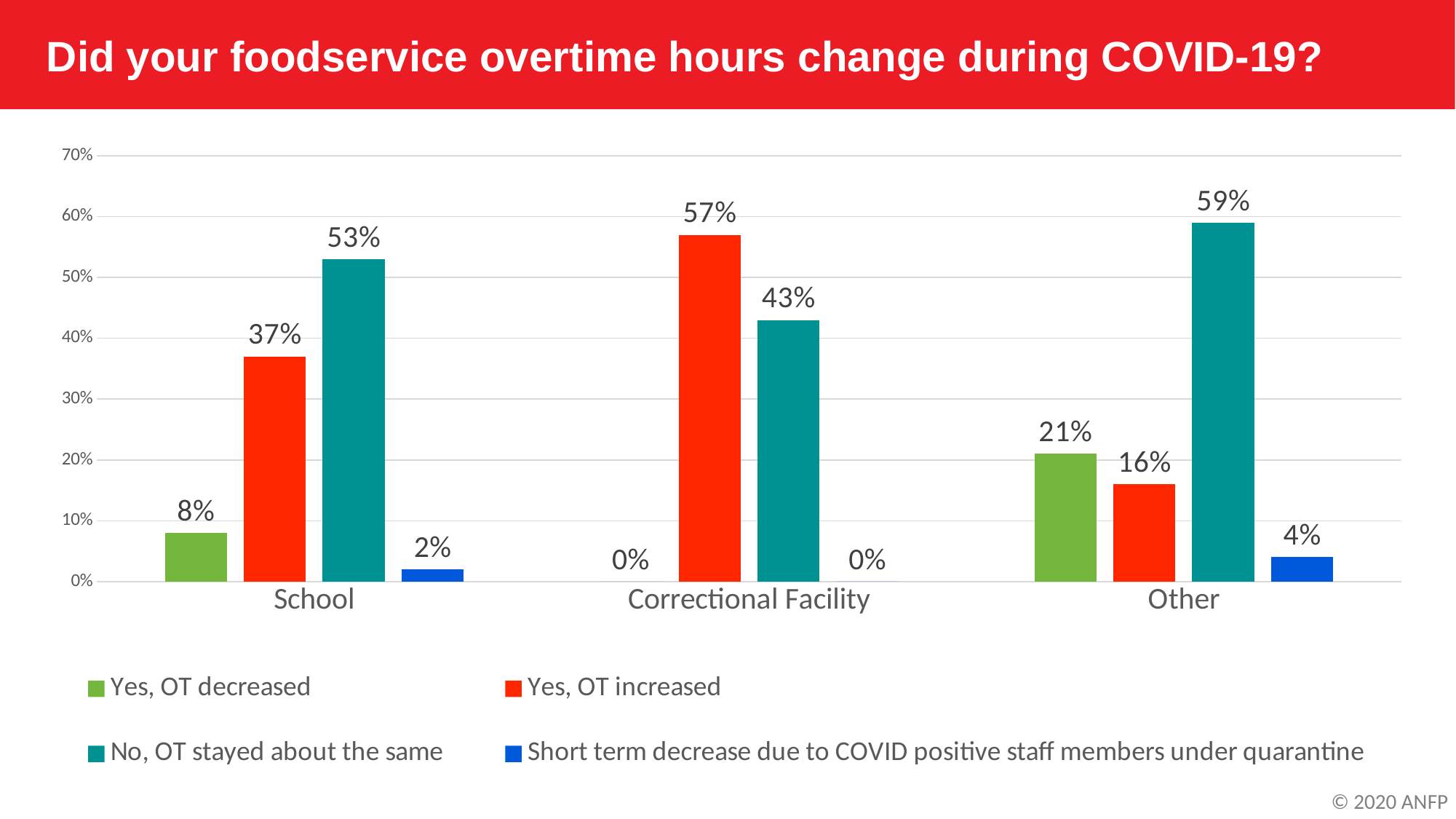
How many series does the legend list? 4 Which category has the highest value for 'No, OT stayed about the same'? Other What percentage of School respondents said OT stayed about the same? 53% What is the title of the chart? Did your foodservice overtime hours change during COVID-19? What is the value for 'Yes, OT decreased' in the Correctional Facility category? 0% Which is larger for the Other category: 'Yes, OT decreased' or 'Yes, OT increased'? Yes, OT decreased Which category has the lowest value for 'Yes, OT increased'? Other What kind of chart is shown on the slide? Bar chart What percentage of Other respondents reported a short term decrease due to COVID positive staff members under quarantine? 4% How many categories are shown on the x axis? 3 What is the value for 'Yes, OT increased' in the Correctional Facility category? 57% What is the difference between 'Yes, OT increased' and 'No, OT stayed about the same' for Correctional Facility? 14%